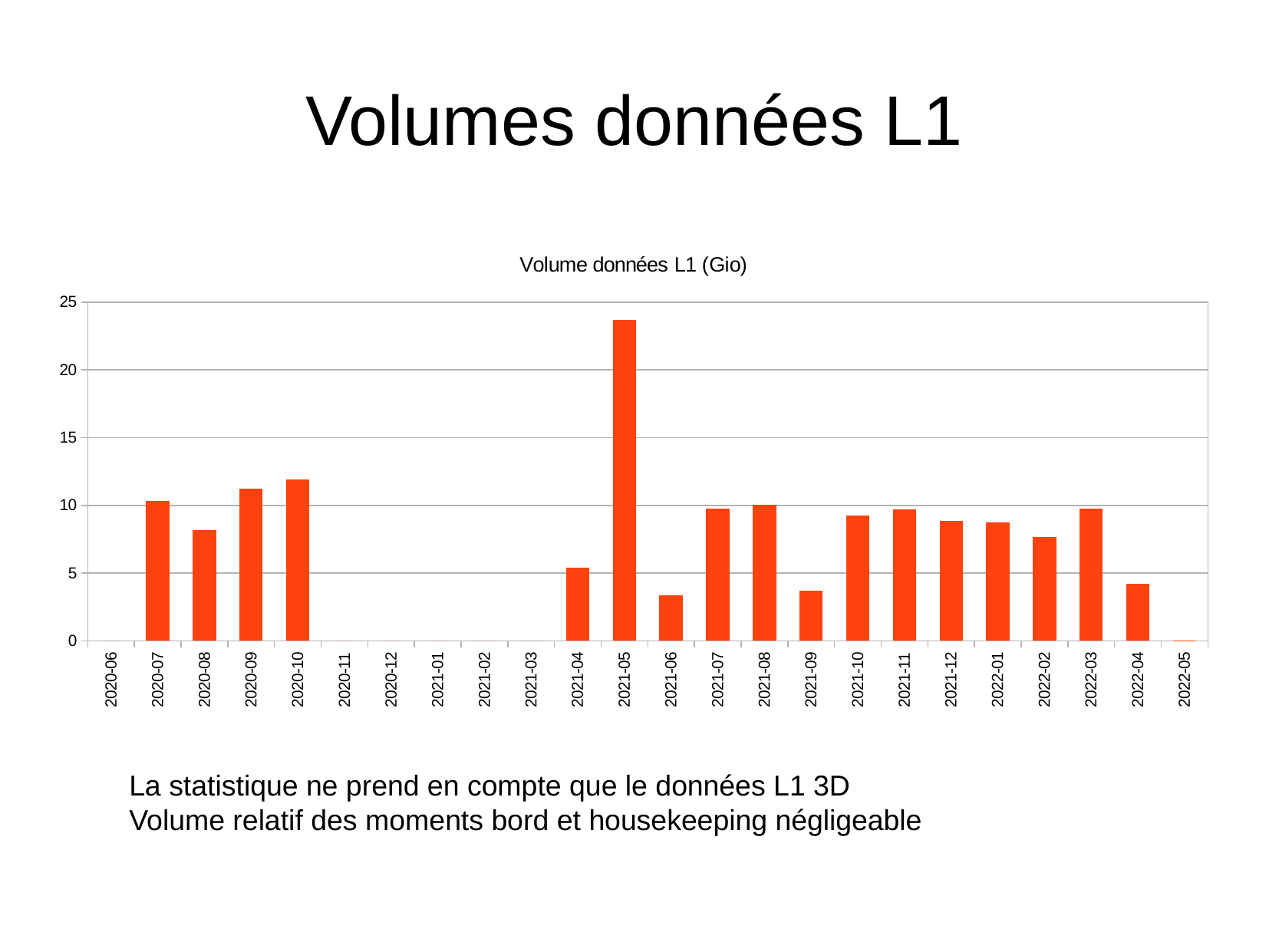
What kind of chart is shown on the slide? bar chart Which month has the highest volume of L1 data? 2021-05 How many months are listed along the x axis of the chart? 24 Is the value for 2022-02 greater or less than 10? less Do the values rise or fall from 2021-11 to 2022-02? fall Is the value for 2020-10 greater or less than 10? greater Is the value for 2021-05 greater or less than 20? greater What is the title of the chart? Volume données L1 (Gio) Which is larger, the value for 2020-09 or the value for 2020-08? 2020-09 What colour are the bars in the chart? orange Which is larger, the value for 2021-04 or the value for 2021-09? 2021-04